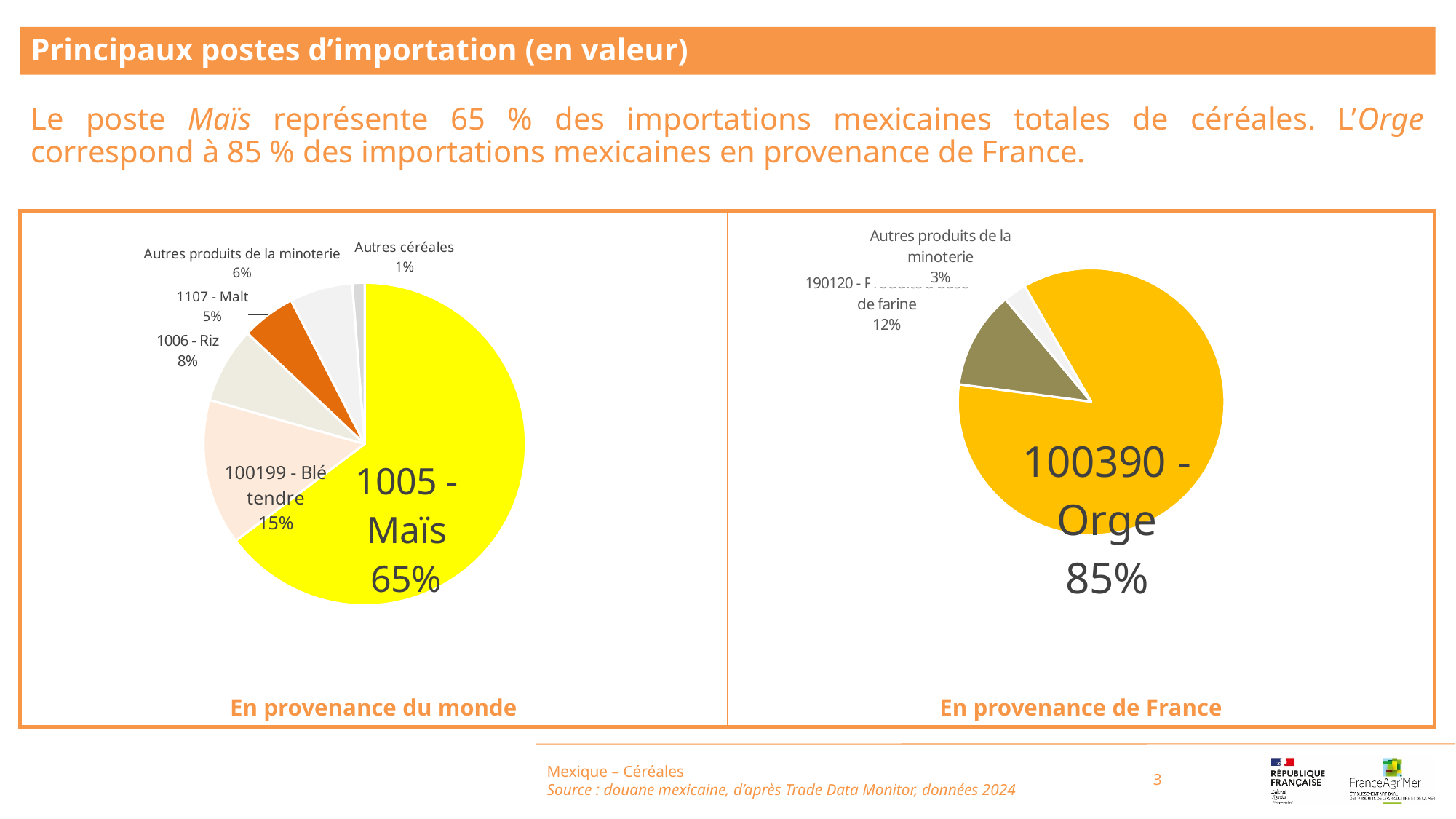
How many slices does the 'En provenance du monde' pie chart have? 6 In the 'En provenance de France' chart, what share does 100390 - Orge represent? 85% What type of chart is used for 'En provenance de France'? Pie chart In the 'En provenance du monde' chart, what share does 1006 - Riz represent? 8% In the 'En provenance du monde' chart, which category has the smallest share? Autres céréales In the 'En provenance du monde' chart, what share does 1005 - Maïs represent? 65% In the 'En provenance du monde' chart, what share does 100199 - Blé tendre represent? 15% How many slices does the 'En provenance de France' pie chart have? 3 In the 'En provenance du monde' chart, which category has the largest share? 1005 - Maïs In the 'En provenance de France' chart, what share does 190120 - Produits à base de farine represent? 12% In the 'En provenance du monde' chart, which has the larger share, Autres produits de la minoterie or 1107 - Malt? Autres produits de la minoterie In the 'En provenance du monde' chart, what is the difference in share between 1006 - Riz and 1107 - Malt? 3%